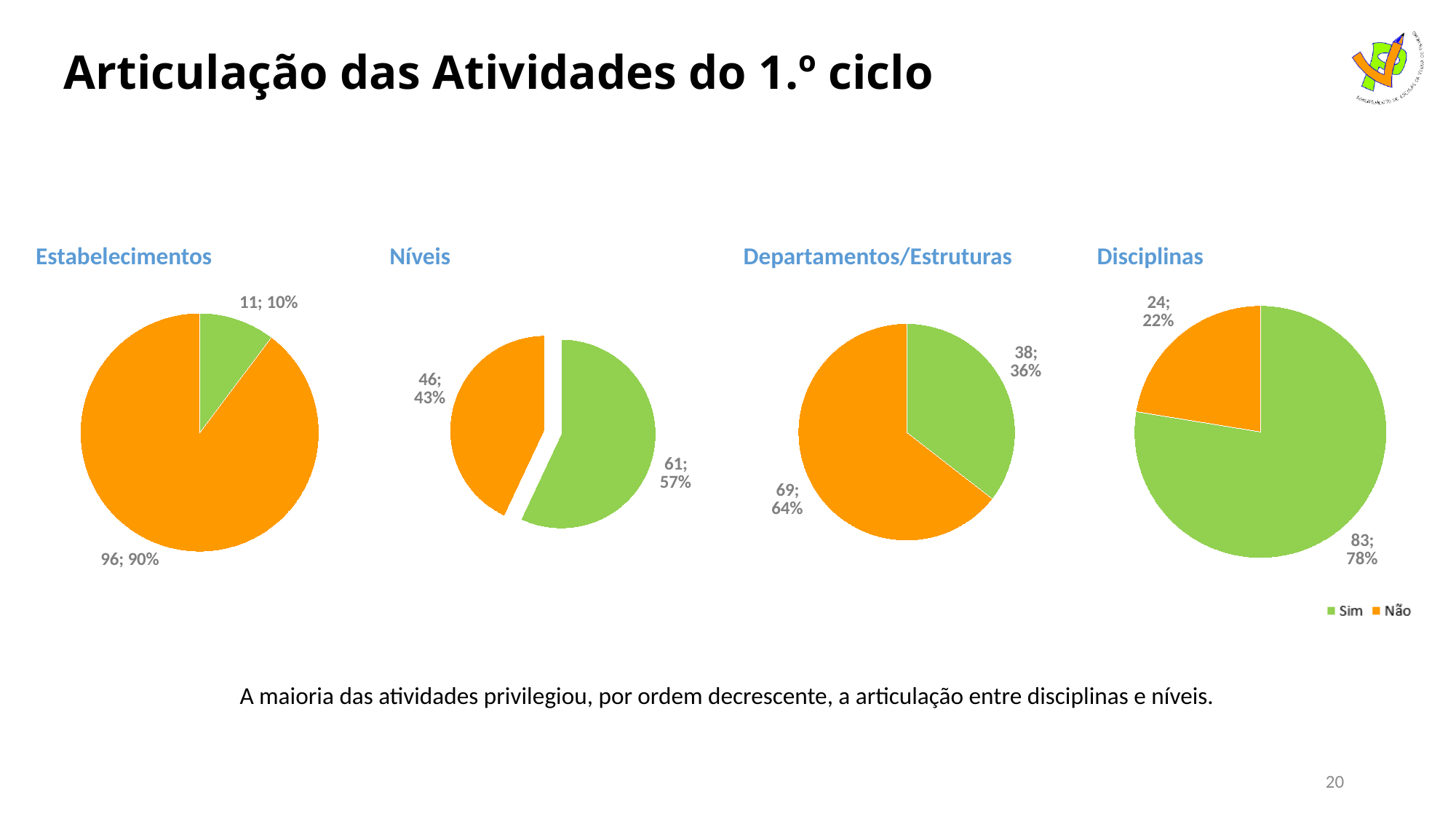
In the 'Departamentos/Estruturas' chart, what is the difference between the counts for 'Não' and 'Sim'? 31 In the 'Disciplinas' chart, what is the value for 'Sim'? 83; 78% In the 'Departamentos/Estruturas' chart, what is the value for 'Não'? 69; 64% In the 'Disciplinas' chart, which slice is the largest? Sim In the 'Estabelecimentos' chart, what share of the pie does 'Sim' take? 10% In the 'Níveis' chart, what is the value for 'Sim'? 61; 57% In the 'Níveis' chart, which slice is larger, 'Sim' or 'Não'? Sim Which colour represents 'Não' in the charts? Orange How many series does the legend list? 2 In the 'Estabelecimentos' chart, what is the value for 'Não'? 96; 90% In the 'Disciplinas' chart, what share of the pie does 'Não' take? 22% What kind of chart is the 'Níveis' chart? Pie chart